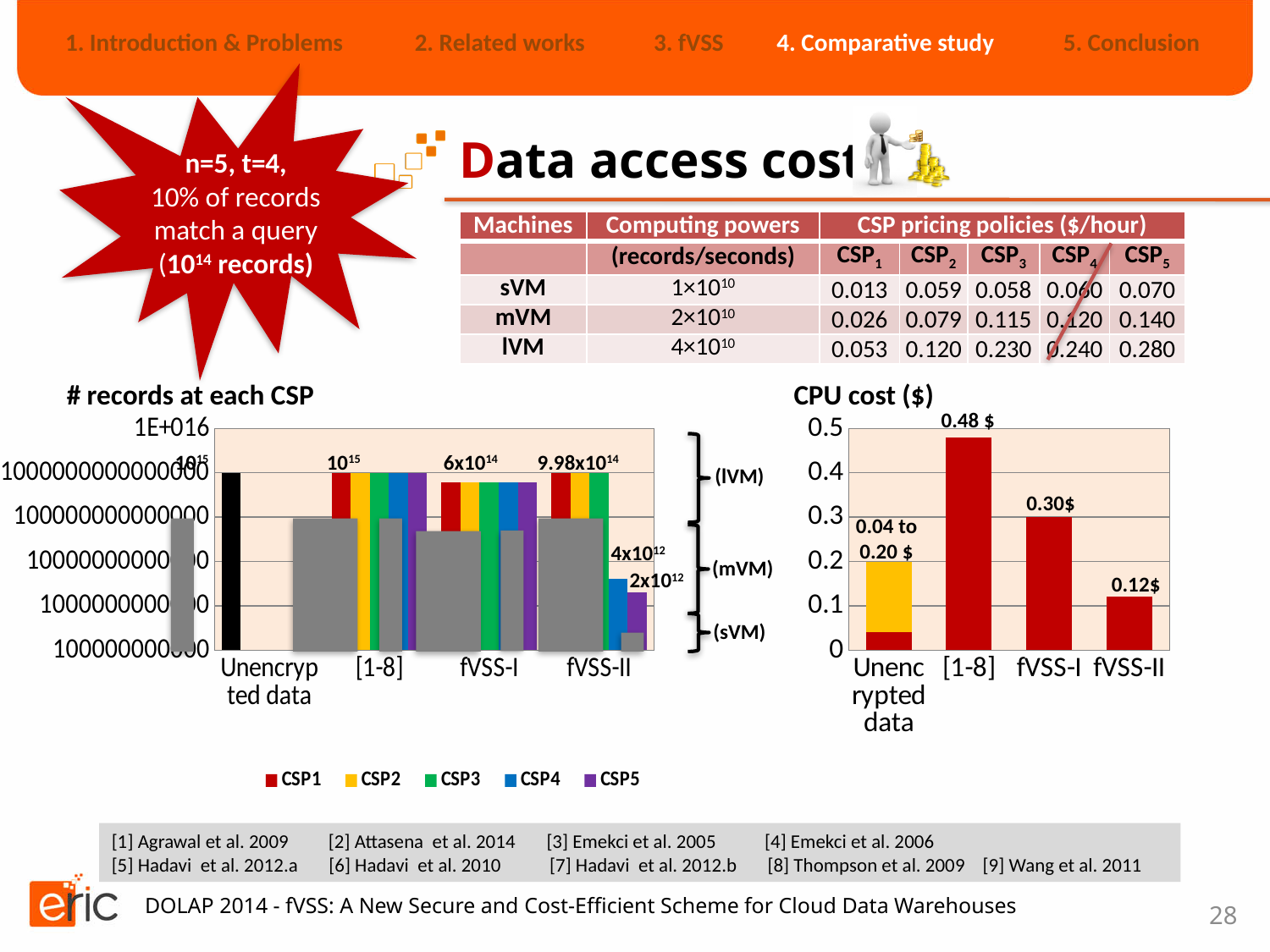
In the CPU cost ($) chart, what is the CPU cost for fVSS-II? 0.12$ In the CPU cost ($) chart, what is the CPU cost for [1-8]? 0.48 $ In the # records at each CSP chart, what is the labelled number of records for fVSS-I? 6x10^14 In the CPU cost ($) chart, is the value for fVSS-II greater or less than 0.2? less In the # records at each CSP chart, what is the labelled number of records for fVSS-II at CSP5? 2x10^12 How many categories are shown on the x axis of the CPU cost ($) chart? 4 In the CPU cost ($) chart, what is the difference between the CPU cost of [1-8] and fVSS-I? 0.18 How many series does the legend of the # records at each CSP chart list? 5 In the CPU cost ($) chart, what is the CPU cost for fVSS-I? 0.30$ What kind of chart is the CPU cost ($) chart? bar chart In the CPU cost ($) chart, which category has the highest CPU cost? [1-8] In the CPU cost ($) chart, which has a larger CPU cost, fVSS-I or fVSS-II? fVSS-I